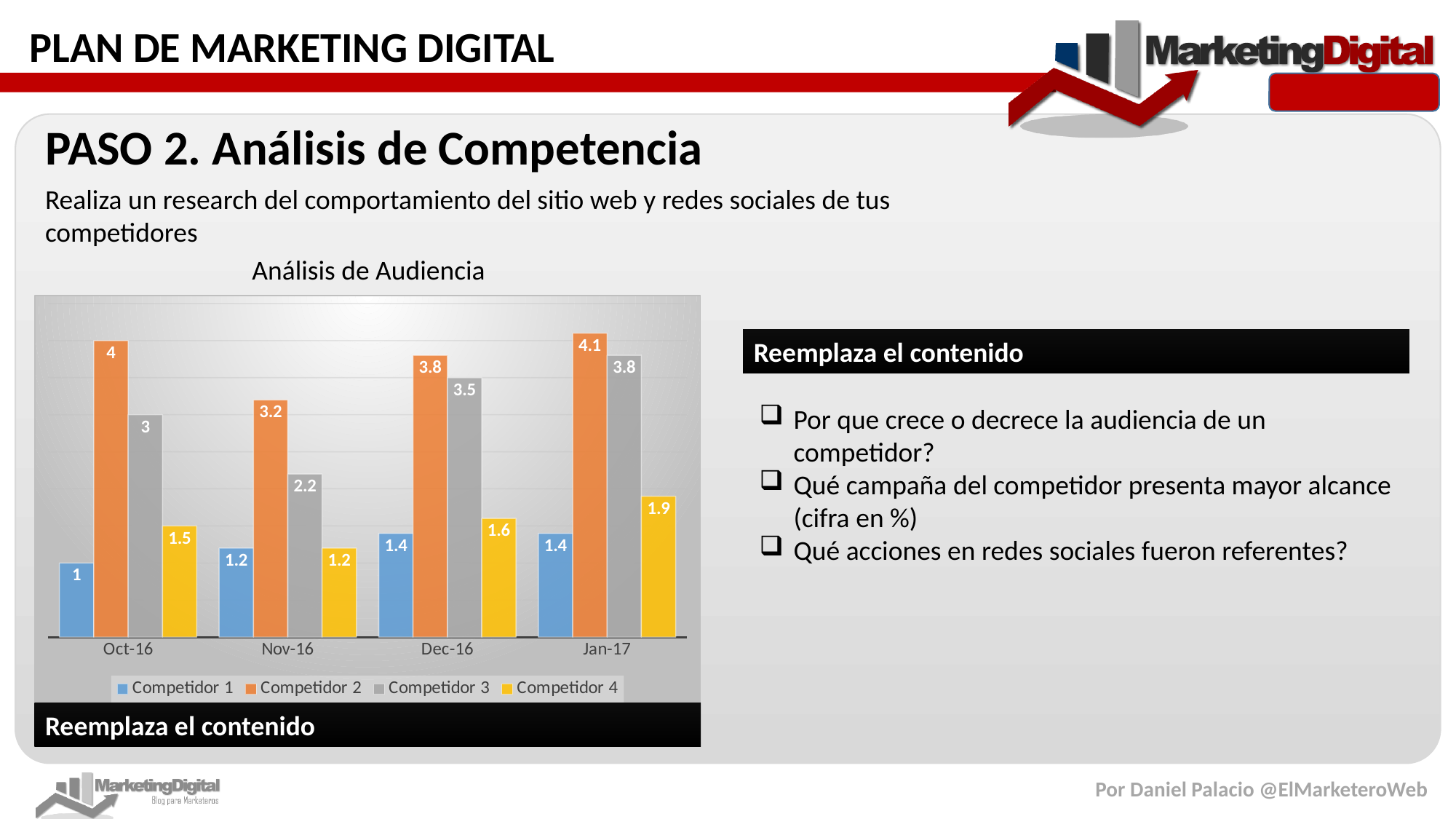
What is the difference between Competidor 2 and Competidor 3 in Jan-17? 0.3 What is the value for Competidor 1 in Dec-16? 1.4 What kind of chart is shown? Bar chart How many series does the legend list? 4 Which competitor has the highest value in Dec-16? Competidor 2 How many months are shown on the x axis? 4 Which competitor has the lowest value in Oct-16? Competidor 1 What is the value for Competidor 3 in Nov-16? 2.2 What is the value for Competidor 2 in Oct-16? 4 Which is larger: Competidor 3 in Dec-16 or Competidor 3 in Jan-17? Competidor 3 in Jan-17 Do the values for Competidor 3 rise or fall from Nov-16 to Jan-17? Rise What is the value for Competidor 4 in Jan-17? 1.9